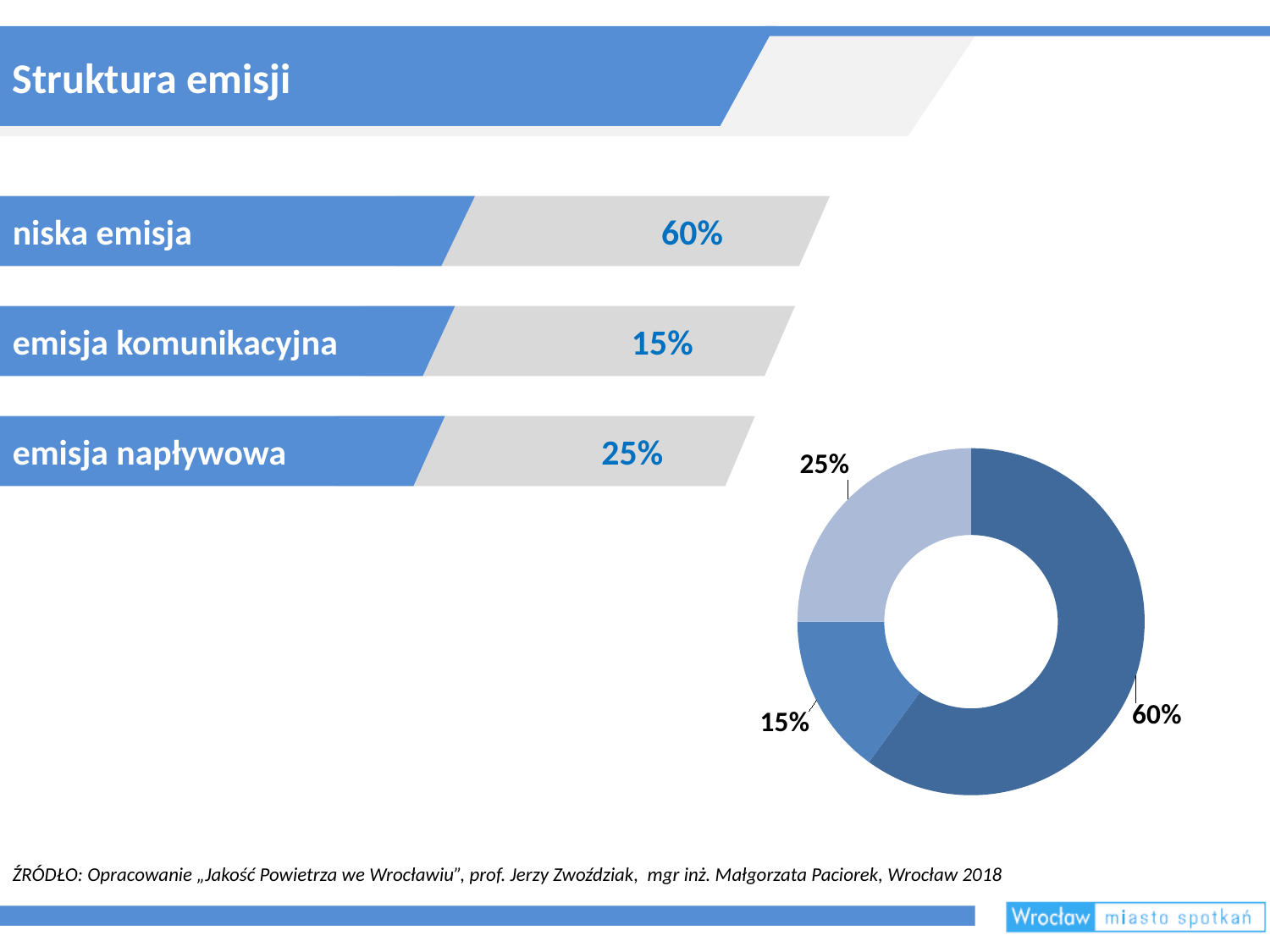
How many slices does the doughnut chart have? 3 What is the difference between the 25% slice and the 15% slice on the doughnut chart? 10% What is the smallest value shown on the doughnut chart? 15% What share of emissions does emisja komunikacyjna account for according to the slide? 15% What is the largest value shown on the doughnut chart? 60% What share of emissions does niska emisja account for according to the slide? 60% Which is larger on the doughnut chart: the 25% slice or the 15% slice? 25% What is the difference between the largest and smallest slices of the doughnut chart? 45% What share of emissions does emisja napływowa account for according to the slide? 25% Which slice of the doughnut chart is drawn in the lightest shade of blue? 25% What is the title of the slide containing the doughnut chart? Struktura emisji What kind of chart is shown on the slide? doughnut chart